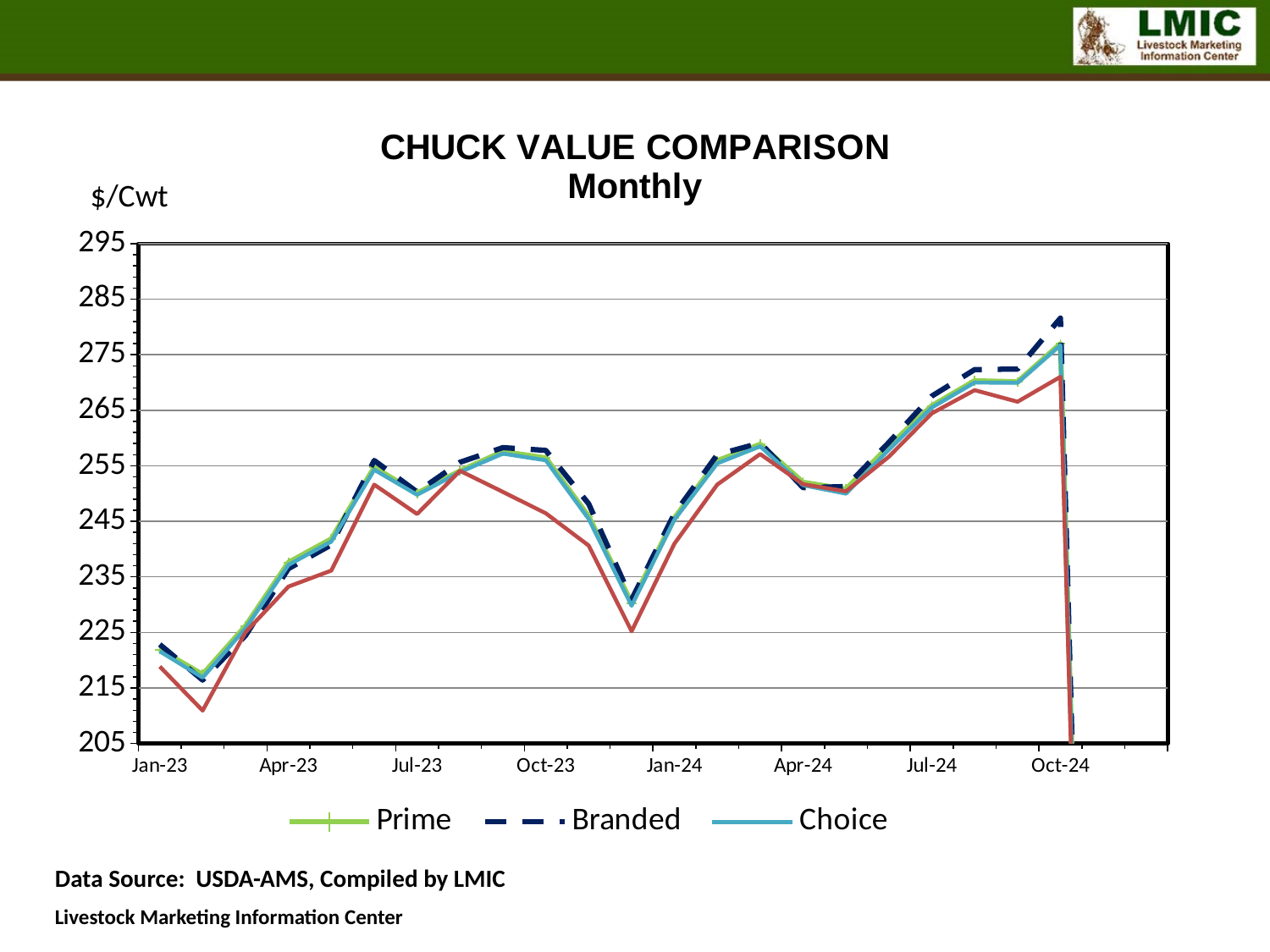
At Oct-24, which is larger, the Branded value or the Choice value? Branded What kind of chart is shown on the slide? line chart Is the value for Branded at Oct-23 greater or less than 245? greater Is the value for Branded at Jan-23 greater or less than 215? greater Is the value for Branded at Oct-24 greater or less than 275? greater How many month labels are shown on the x axis? 8 What unit is shown on the y axis of the chart? $/Cwt How many series does the legend list? 3 What is the title of the chart? CHUCK VALUE COMPARISON Monthly Does the Branded series rise or fall from Jan-23 to Jul-23? rise